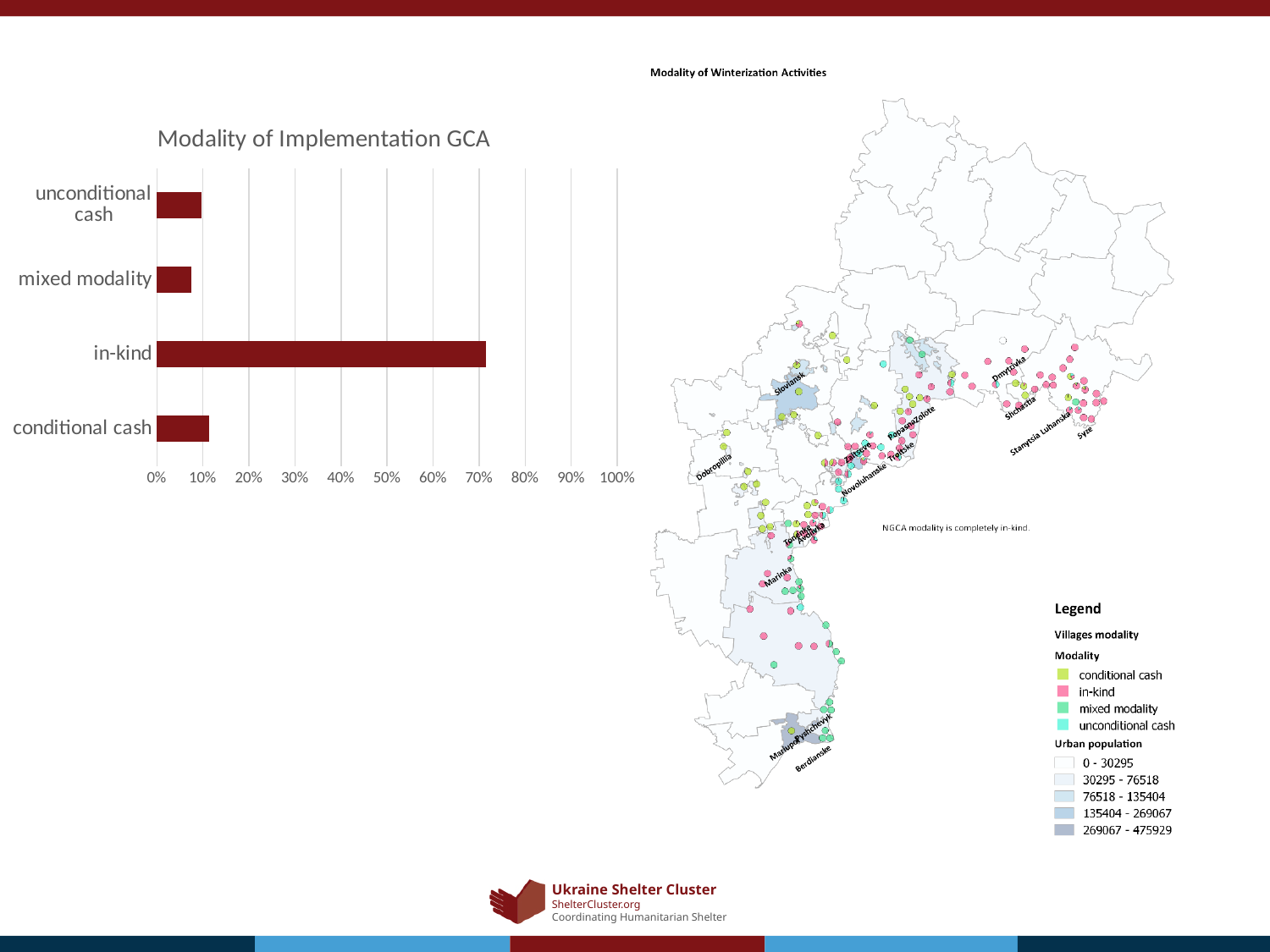
In the 'Modality of Implementation GCA' chart, is the value for mixed modality greater or less than 10%? less In the 'Modality of Implementation GCA' chart, is the value for unconditional cash greater or less than 20%? less In the 'Modality of Implementation GCA' chart, which modality has the lowest value? mixed modality In the 'Modality of Implementation GCA' chart, which is larger: in-kind or conditional cash? in-kind What is the title of the bar chart on the left of the slide? Modality of Implementation GCA What kind of chart is 'Modality of Implementation GCA'? bar chart In the 'Modality of Implementation GCA' chart, which modality has the highest value? in-kind What is the maximum value shown on the x axis of the 'Modality of Implementation GCA' chart? 100% In the 'Modality of Implementation GCA' chart, which is larger: unconditional cash or mixed modality? unconditional cash In the 'Modality of Implementation GCA' chart, is the value for conditional cash greater or less than 30%? less How many categories are shown in the 'Modality of Implementation GCA' chart? 4